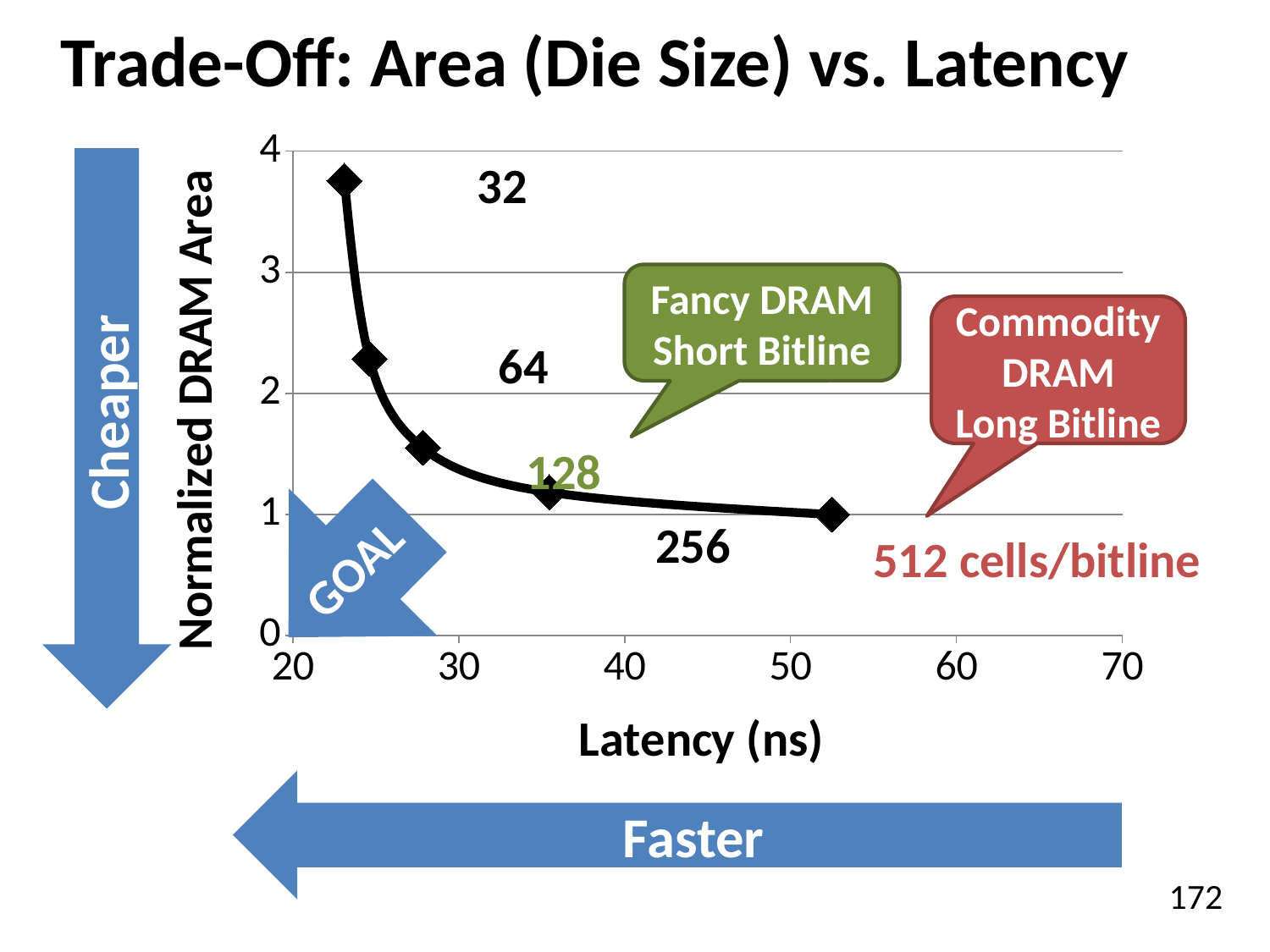
How many data points are plotted on the chart? 5 What kind of chart is shown on the slide? line chart What is the label of the y axis? Normalized DRAM Area Which labeled point has the lowest normalized DRAM area? 512 cells/bitline Is the normalized DRAM area for the point labeled 128 greater or less than 2? less Is the latency for the point labeled 512 cells/bitline greater or less than 50 ns? greater Is the normalized DRAM area for the point labeled 32 greater or less than 3? greater Which labeled point has the highest normalized DRAM area? 32 As latency increases along the x axis, does the normalized DRAM area rise or fall? fall What is the label of the x axis? Latency (ns) Which has the larger normalized DRAM area, the point labeled 32 or the point labeled 256? 32